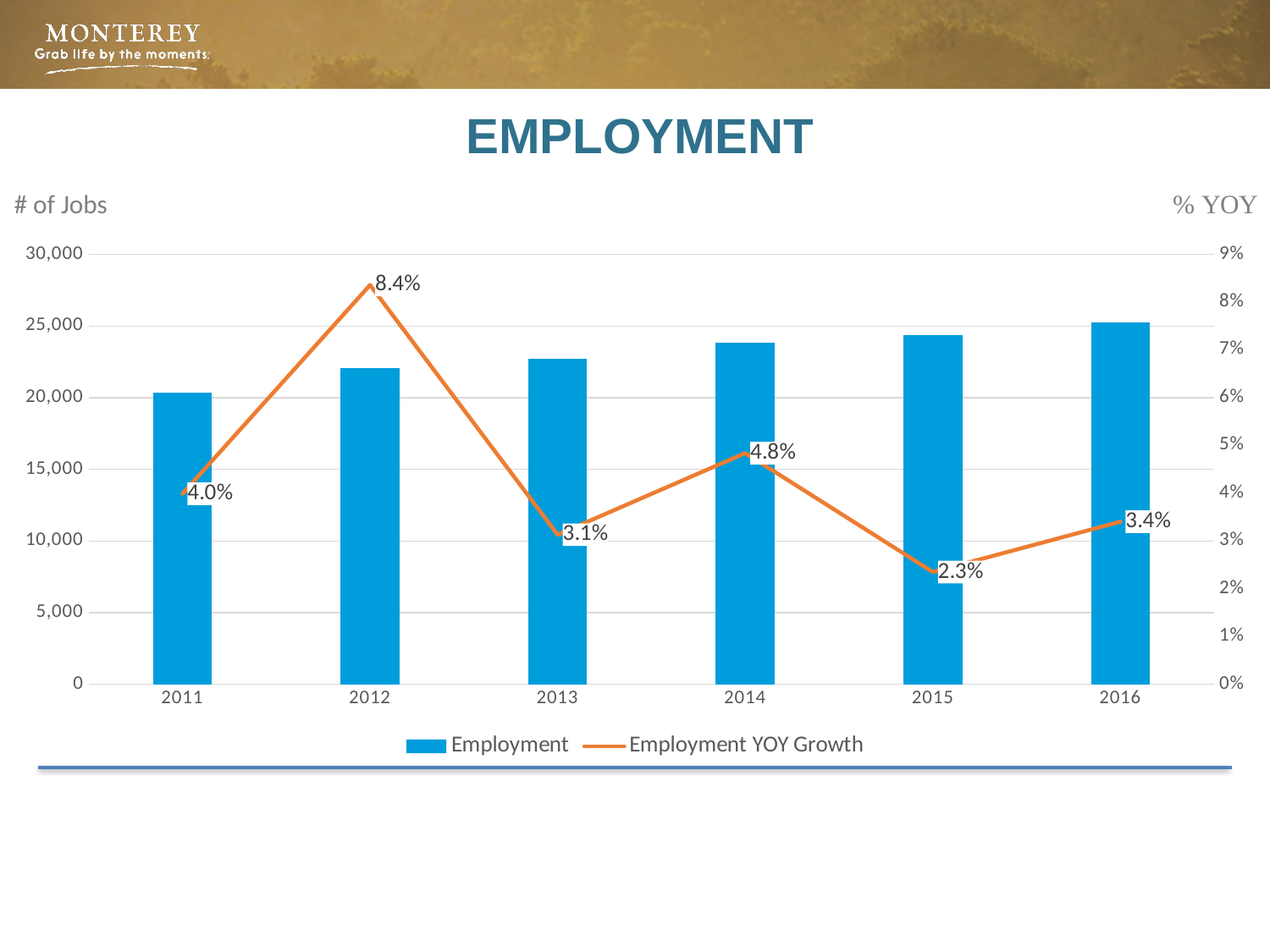
What is the difference between the Employment YOY Growth in 2012 and 2013? 5.3% Do the Employment bars rise or fall from 2011 to 2016? rise Which year has the highest Employment YOY Growth? 2012 How many years are shown on the x axis? 6 Which year has the lowest Employment YOY Growth? 2015 Which year has a higher Employment YOY Growth, 2011 or 2014? 2014 What is the Employment YOY Growth value for 2016? 3.4% What is the Employment YOY Growth value for 2012? 8.4% How many series does the legend list? 2 What is the Employment YOY Growth value for 2015? 2.3% Is the Employment value for 2016 greater or less than 25,000? greater Is the Employment value for 2011 greater or less than 25,000? less